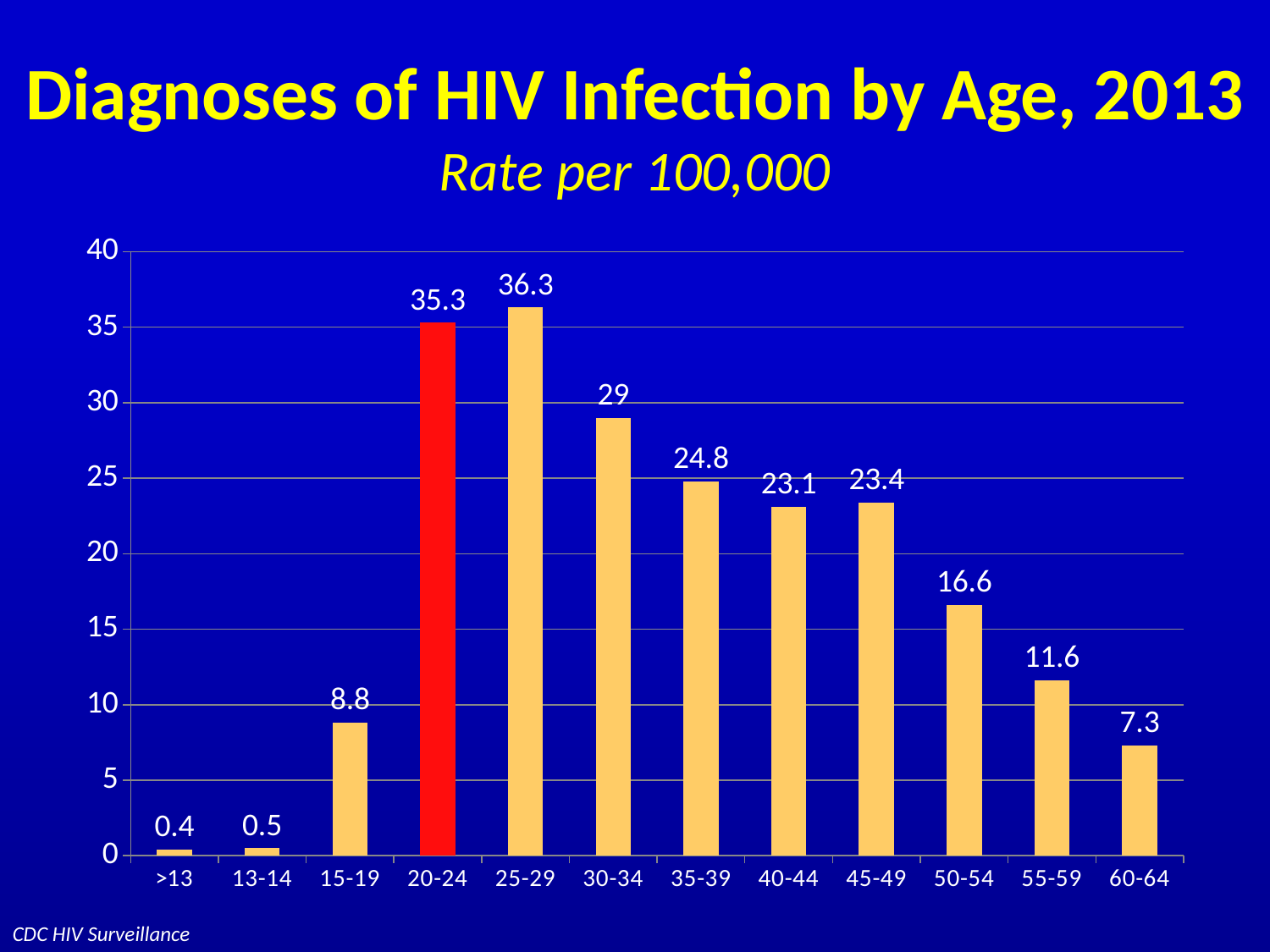
Which age group has the highest rate of HIV diagnoses? 25-29 What is the rate per 100,000 for the 60-64 age group? 7.3 Which age group has a higher rate, 40-44 or 45-49? 45-49 What is the rate per 100,000 for the 20-24 age group? 35.3 What is the difference between the rates for the 25-29 and 20-24 age groups? 1 What is the rate per 100,000 for the 50-54 age group? 16.6 Which age group's bar is highlighted in red? 20-24 Which age group has the lowest rate of HIV diagnoses? >13 How many age groups are shown on the chart? 12 What kind of chart is shown on the slide? Bar chart What is the difference between the rates for the 30-34 and 35-39 age groups? 4.2 Is the value for the 55-59 age group greater or less than 10? greater